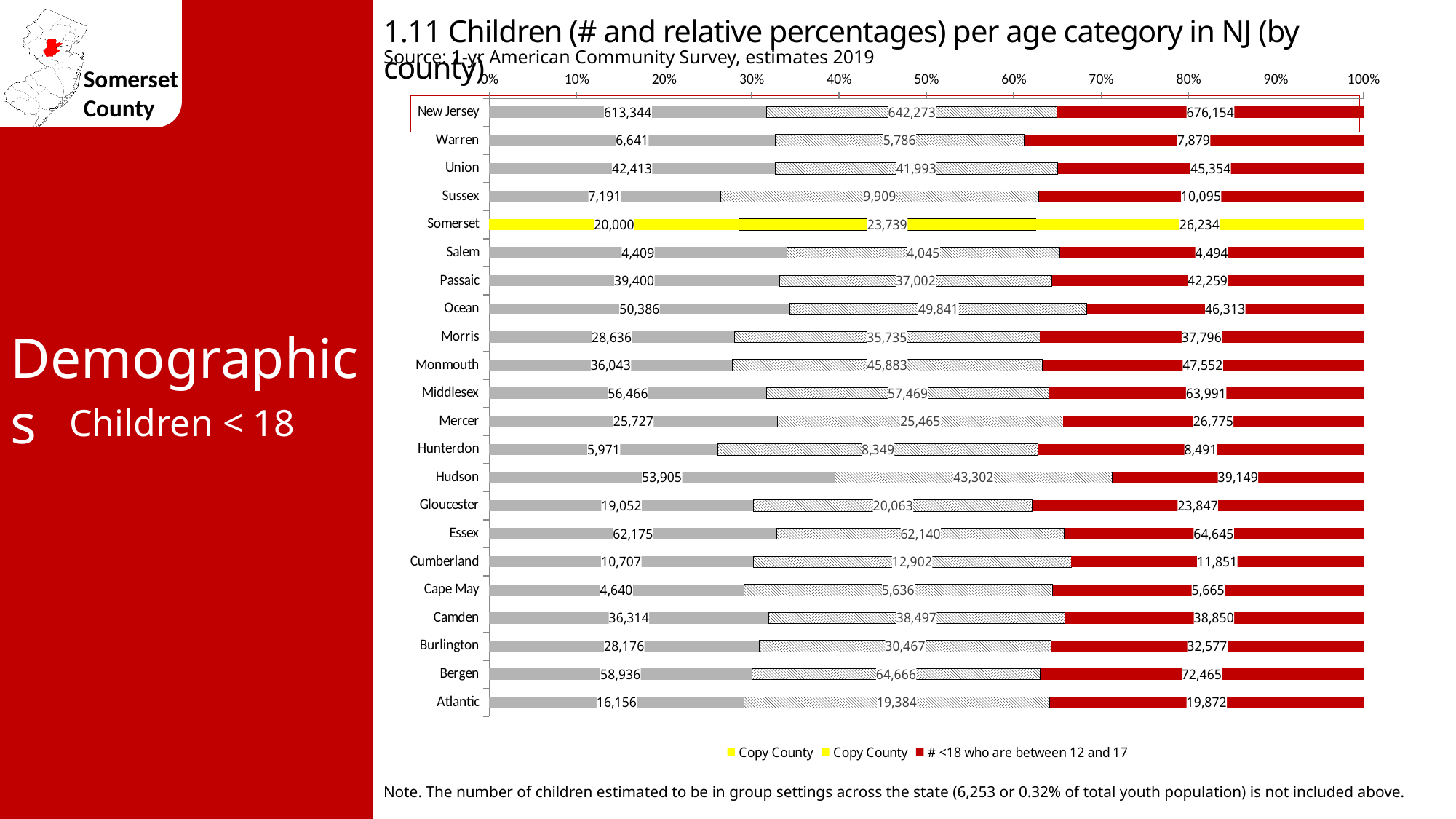
What is the value of the middle segment for Bergen? 64,666 Among the counties (excluding New Jersey), which has the highest value for '# <18 who are between 12 and 17'? Bergen What kind of chart is shown on the slide? Stacked bar chart What is the value of the leftmost (first) segment for Hudson? 53,905 Which is larger: the leftmost segment value for Hudson or for Bergen? Bergen How many series does the legend list? 3 How many categories (rows) are plotted on the chart? 22 What is the difference between Bergen's and Somerset's values for '# <18 who are between 12 and 17'? 46,231 Is the share of Hudson's leftmost segment greater or less than 30%? greater What is the total of the three segments for Somerset? 69,973 What is the value of '# <18 who are between 12 and 17' for Somerset? 26,234 Among the counties (excluding New Jersey), which has the lowest value for '# <18 who are between 12 and 17'? Salem